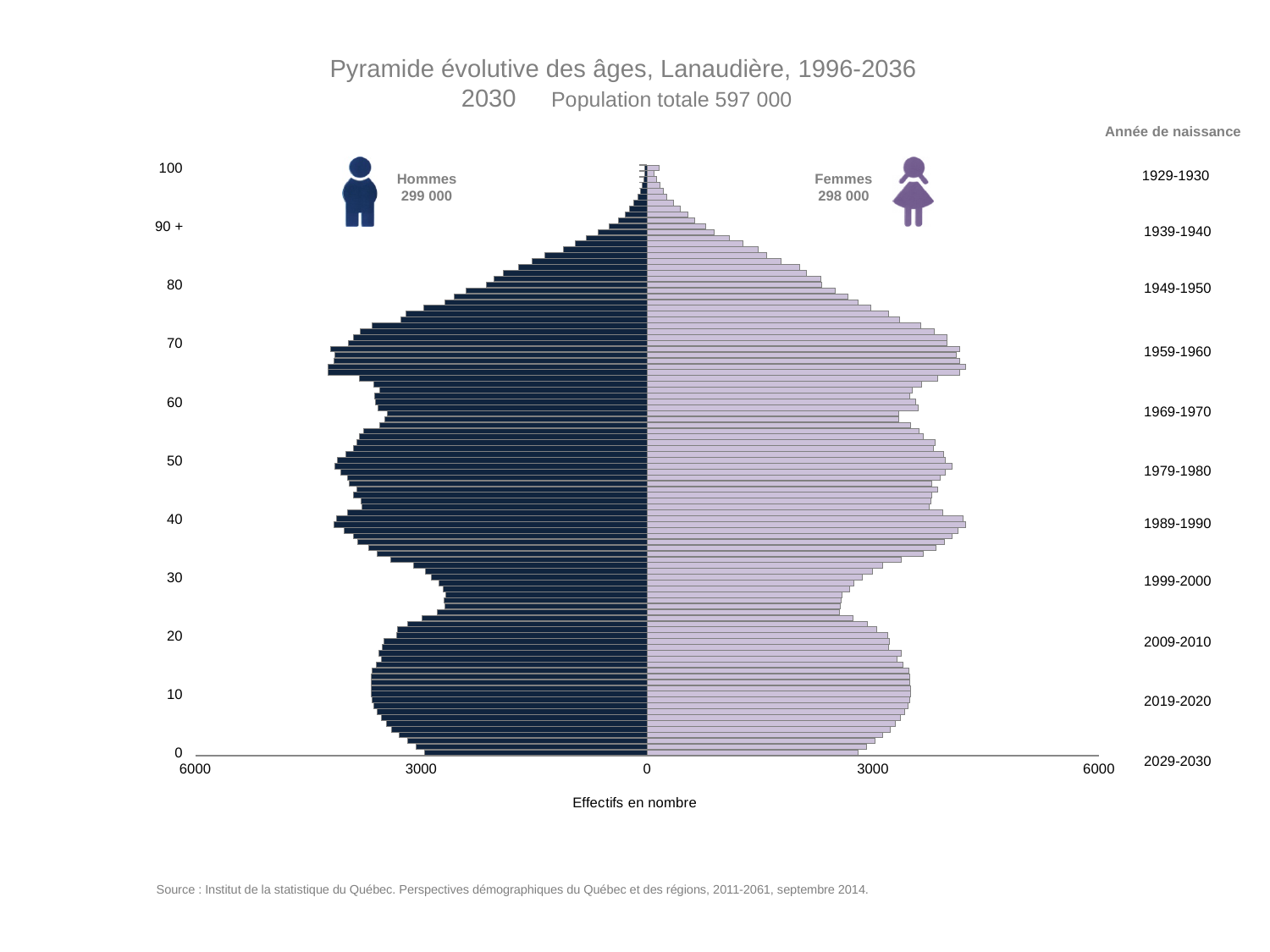
What is the label of the horizontal axis? Effectifs en nombre What is the number of Femmes (women) shown on the chart? 298 000 Do the bar lengths rise or fall as age increases from 70 to 100? fall Which group is larger, Hommes or Femmes? Hommes What is the total population shown for 2030? 597 000 Is the value for Hommes at age 80 greater or less than 3000? less What is the difference between the number of Hommes and the number of Femmes? 1 000 Is the value for Hommes at age 40 greater or less than 3000? greater What kind of chart is shown on the slide? bar chart What is the number of Hommes (men) shown on the chart? 299 000 Is the value for Femmes at age 10 greater or less than 3000? greater How many population groups (series) does the chart show? 2